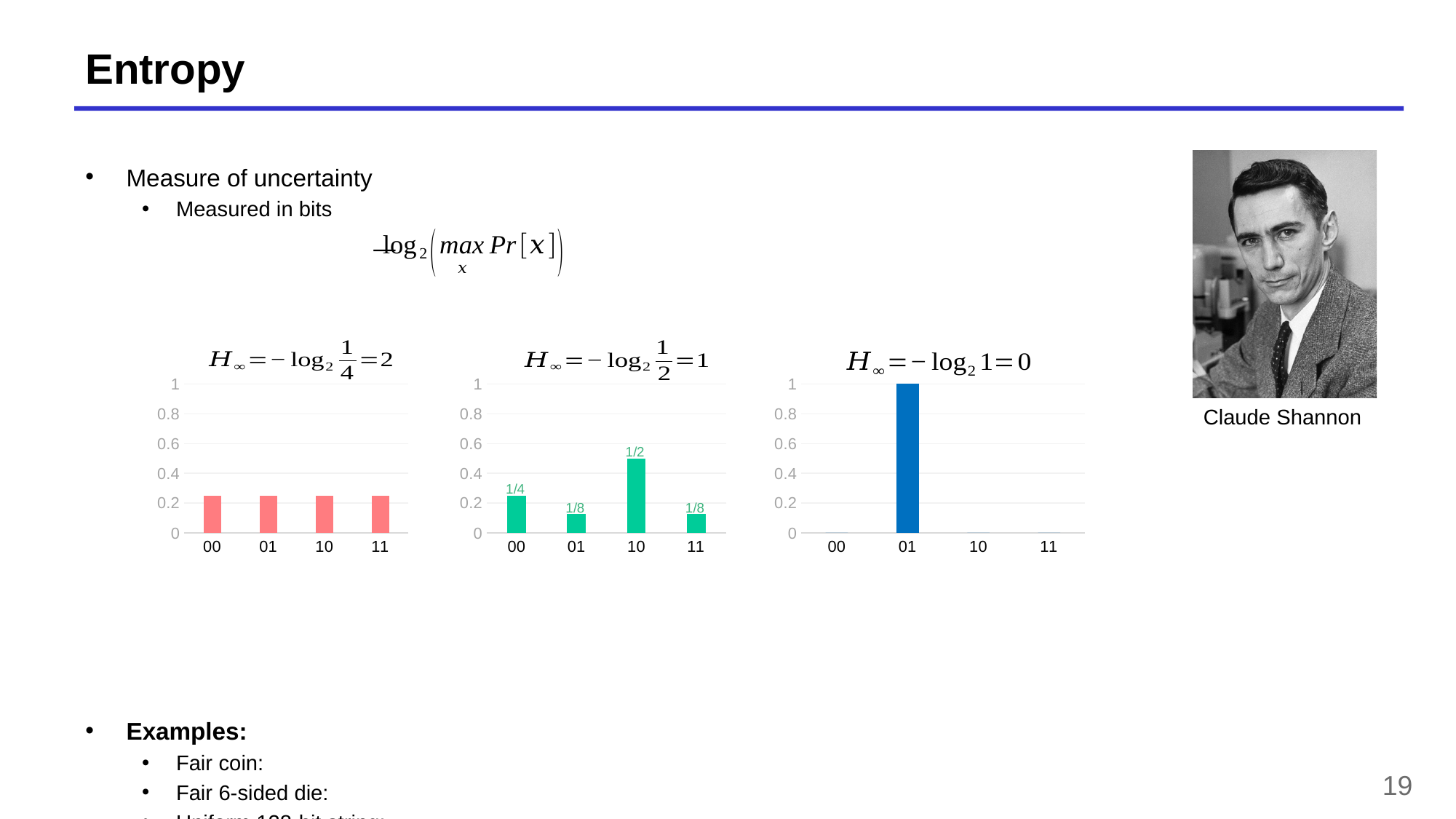
In the right chart, what is the value for category 01? 1 In the left chart, is the value for 00 greater or less than 0.4? less In the right chart, which category has the highest value? 01 In the middle chart, what is the value for category 10? 1/2 In the middle chart, what is the difference between the values for 10 and 00? 1/4 In the middle chart, which category has the highest value? 10 What kind of chart is the middle chart? bar chart How many categories are shown on the x axis of the left chart? 4 In the middle chart, what is the value for category 00? 1/4 In the left chart, is the value for 11 greater or less than 0.2? greater What colour are the bars in the right chart? blue In the middle chart, which is larger, the value for 00 or the value for 01? 00